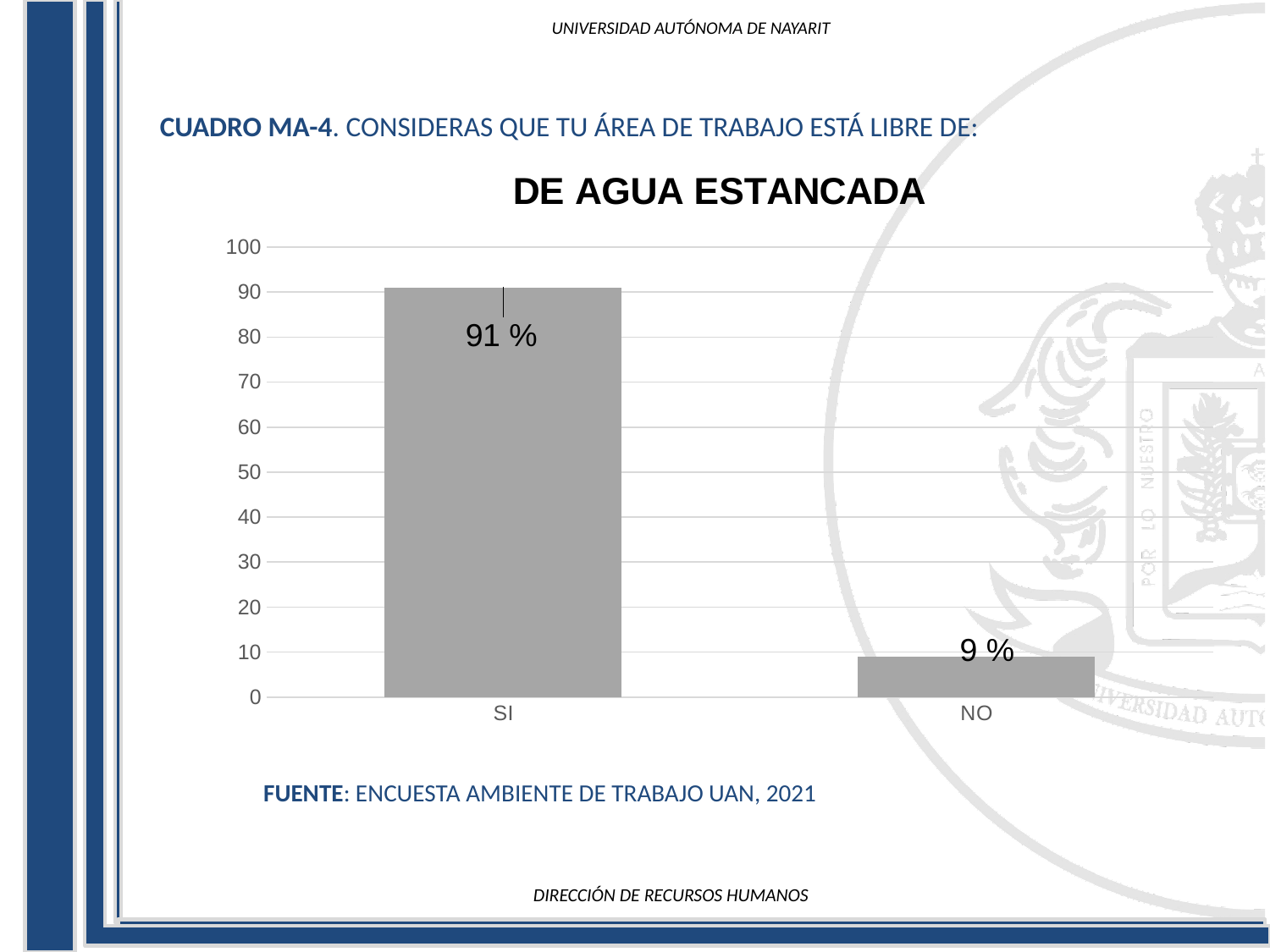
What is the title of the chart? DE AGUA ESTANCADA What is the maximum value shown on the y axis? 100 What is the value for NO? 9 % What is the difference between the values for SI and NO? 82 % What kind of chart is shown? bar chart How many categories are shown on the x axis? 2 Which category has the highest value? SI Is the value for SI greater or less than 80? greater What is the value for SI? 91 % Is the value for NO greater or less than 20? less Which category has the lowest value? NO Which is larger, the value for SI or the value for NO? SI